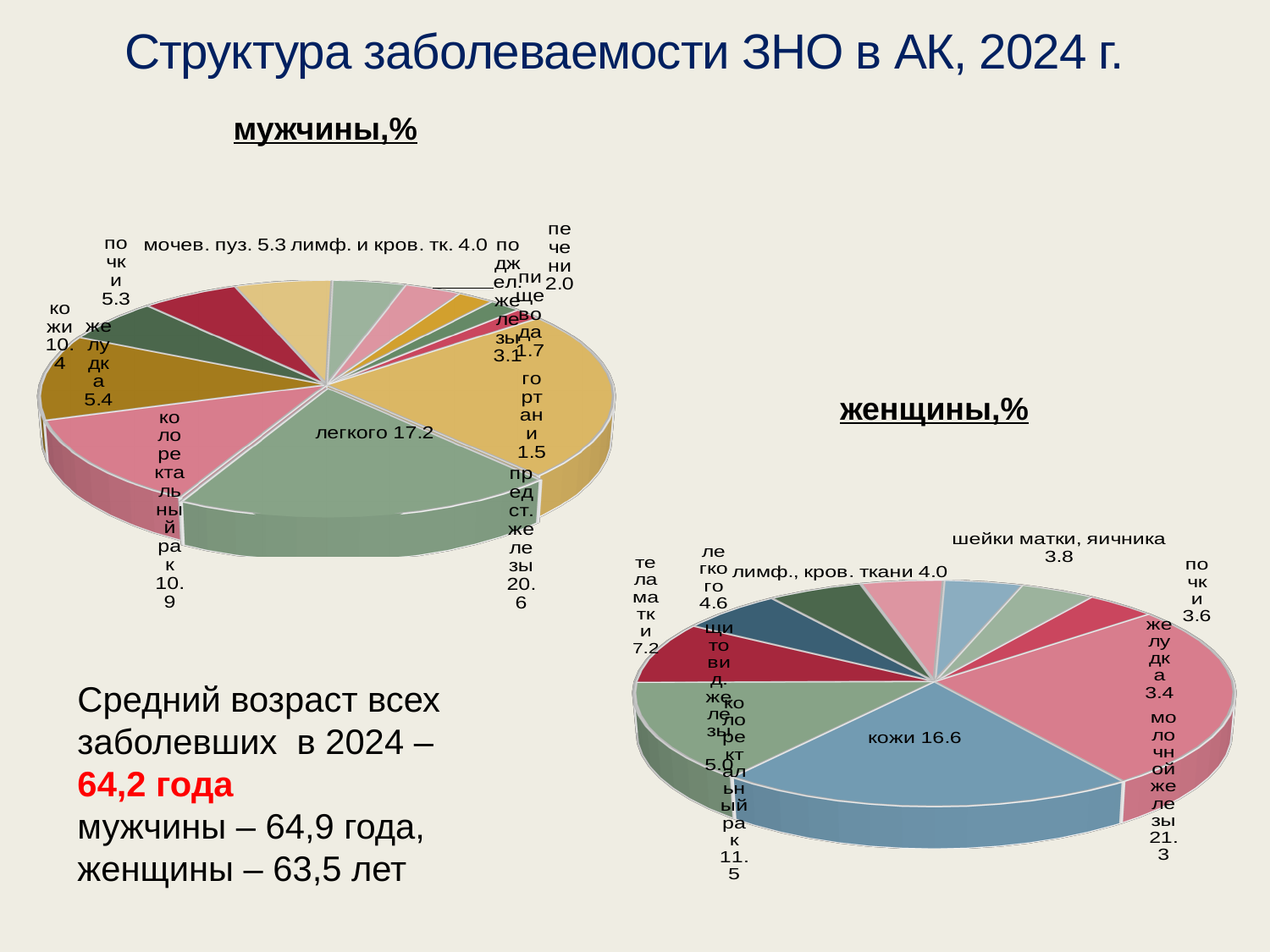
On the women's chart (женщины,%), which is larger: кожи or колоректальный рак? кожи What type of chart is used for the men's chart (мужчины,%)? pie chart On the men's chart (мужчины,%), which category has the largest share? предст. железы On the men's chart (мужчины,%), what is the value for колоректальный рак? 10.9 On the women's chart (женщины,%), what is the value for кожи? 16.6 On the women's chart (женщины,%), what is the value for шейки матки, яичника? 3.8 On the women's chart (женщины,%), what is the value for лимф., кров. ткани? 4.0 On the women's chart (женщины,%), what is the difference between молочной железы and кожи? 4.7 On the women's chart (женщины,%), which category has the largest share? молочной железы On the men's chart (мужчины,%), what is the difference between предст. железы and легкого? 3.4 On the men's chart (мужчины,%), what is the value for мочев. пуз.? 5.3 On the men's chart (мужчины,%), what is the value for легкого? 17.2